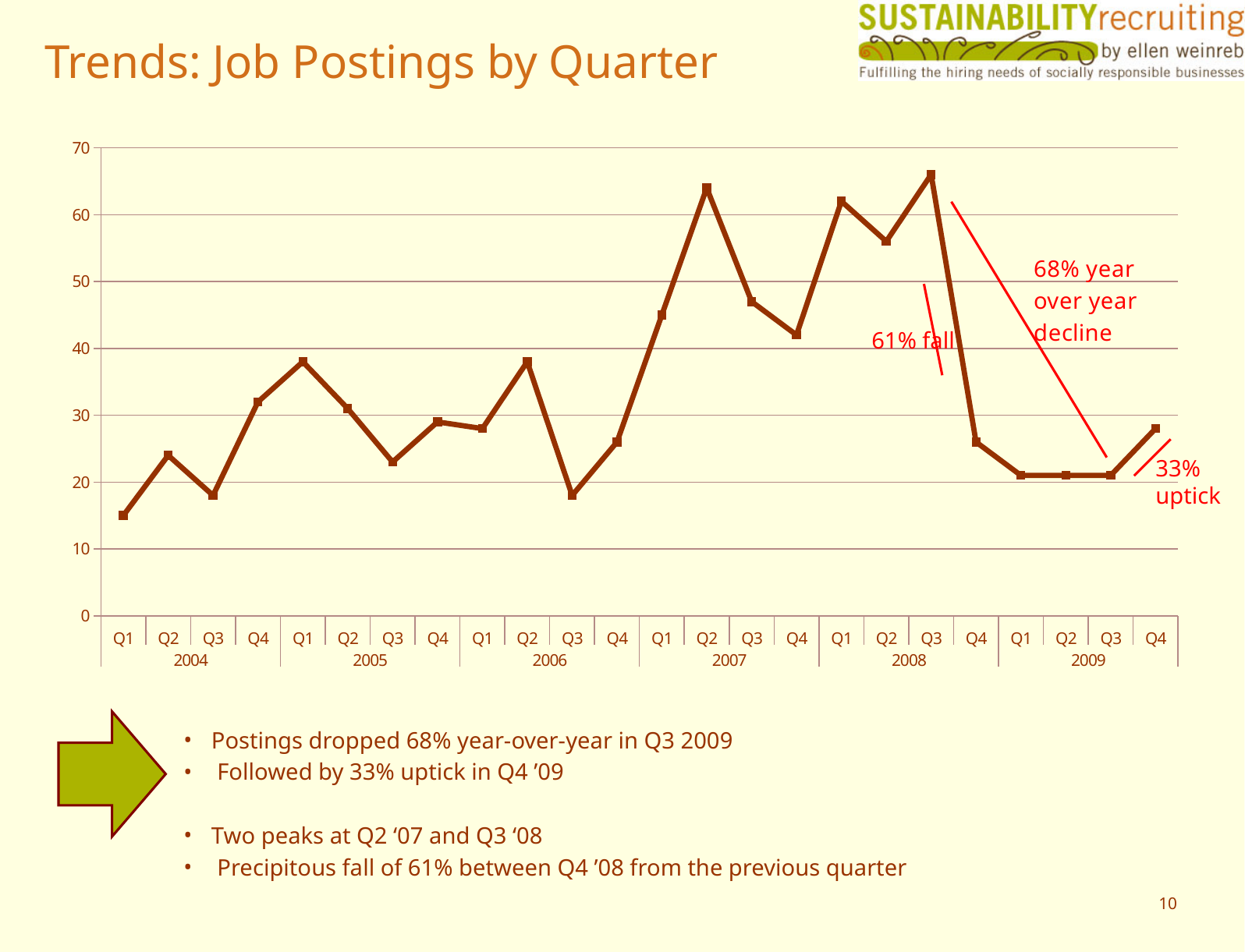
Is the value for Q4 2008 greater or less than 20? greater Which quarter has the highest number of job postings? Q3 2008 Which is larger, the value for Q1 2008 or the value for Q2 2008? Q1 2008 What is the title of the slide's chart? Trends: Job Postings by Quarter What percentage uptick does the annotation near Q4 2009 indicate? 33% uptick How many quarterly data points are plotted on the chart? 24 Do job postings rise or fall from Q3 2008 to Q4 2008? fall Is the value for Q2 2007 greater or less than 60? greater Is the value for Q1 2007 greater or less than 40? greater Which quarter has the lowest number of job postings? Q1 2004 What kind of chart is shown on the slide? line chart